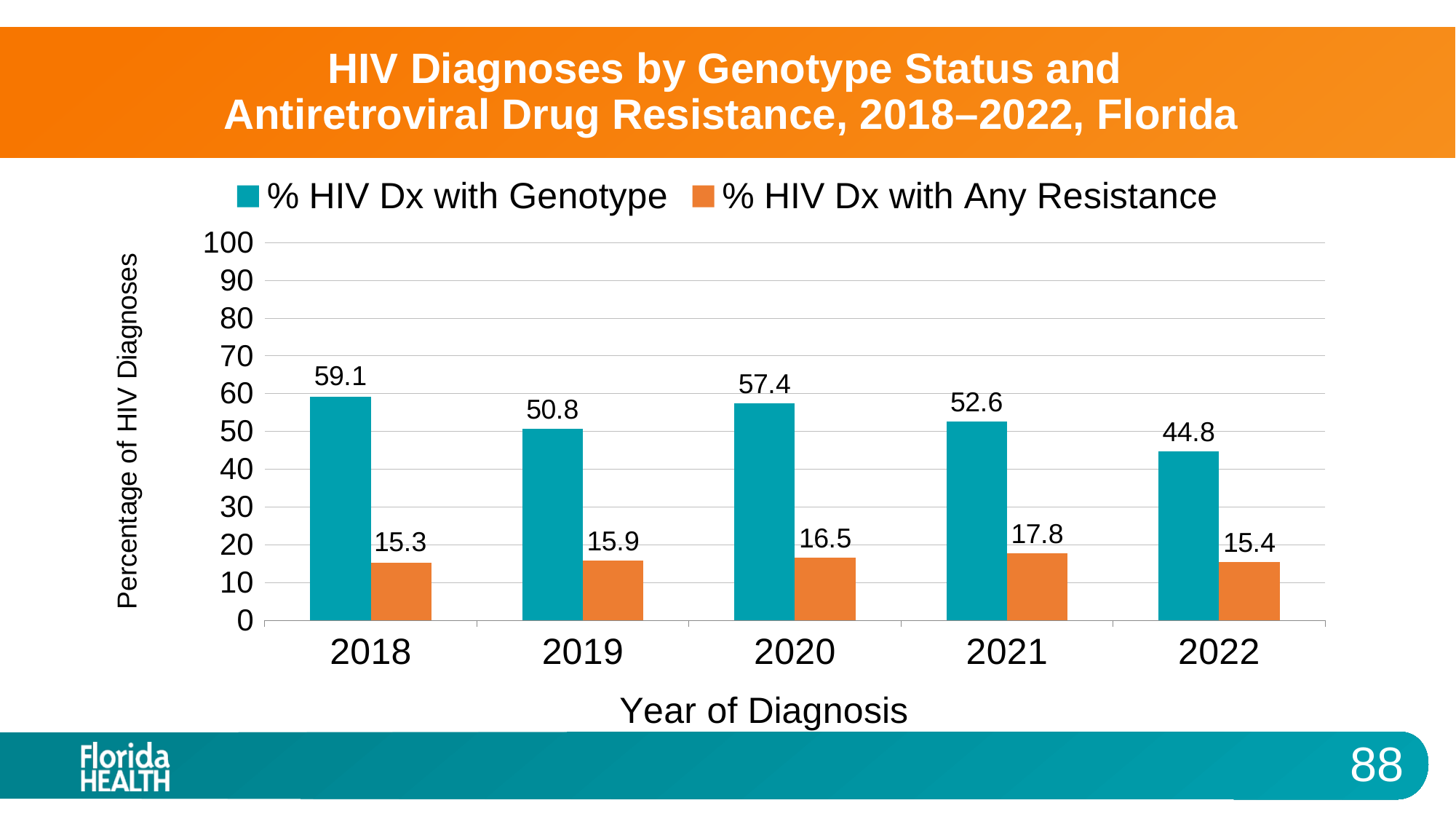
What is the difference between the % HIV Dx with Genotype values for 2018 and 2022? 14.3 How many years are shown on the x axis? 5 What is the value for % HIV Dx with Genotype in 2022? 44.8 Which year has the highest value for % HIV Dx with Genotype? 2018 What is the value for % HIV Dx with Any Resistance in 2021? 17.8 How many series does the legend list? 2 What is the value for % HIV Dx with Genotype in 2018? 59.1 Which is larger: % HIV Dx with Genotype in 2019 or in 2020? 2020 Is the value for % HIV Dx with Genotype in 2021 greater or less than 50? greater What kind of chart is shown on the slide? bar chart What is the label of the y axis? Percentage of HIV Diagnoses Which year has the lowest value for % HIV Dx with Any Resistance? 2018